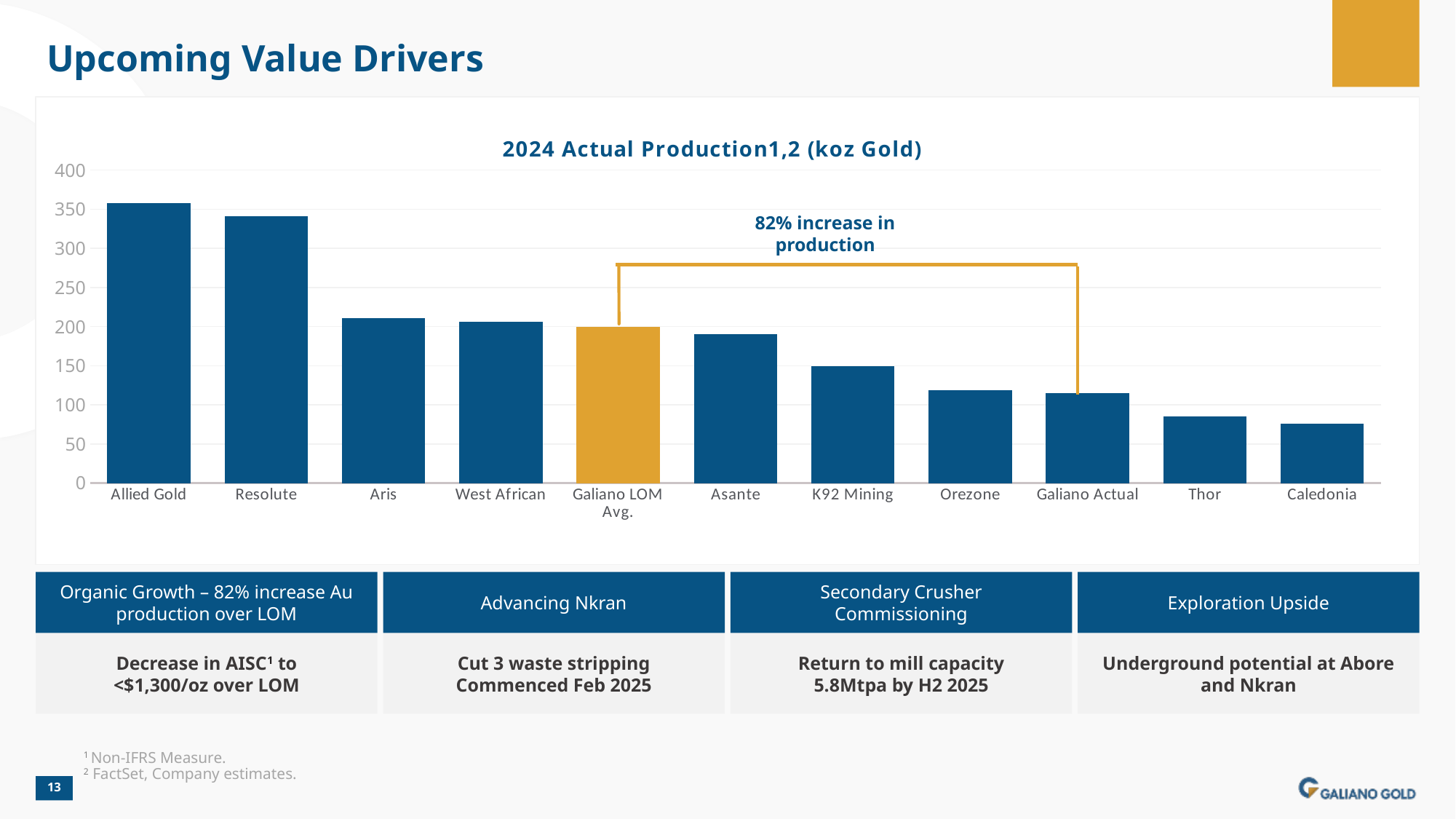
How many companies are shown on the x axis of the chart? 11 Is the value for Allied Gold greater or less than 300? greater Is the value for Orezone greater or less than 100? greater What kind of chart is shown on the slide? Bar chart What percentage increase in production does the annotation on the chart state? 82% Which company has the lowest 2024 actual production in the chart? Caledonia Which bar in the chart is coloured gold rather than blue? Galiano LOM Avg. Which is larger, the value for Resolute or the value for Aris? Resolute Is the value for Thor greater or less than 100? less Do the bar values rise or fall moving from left to right along the x axis? Fall Which company has the highest 2024 actual production in the chart? Allied Gold